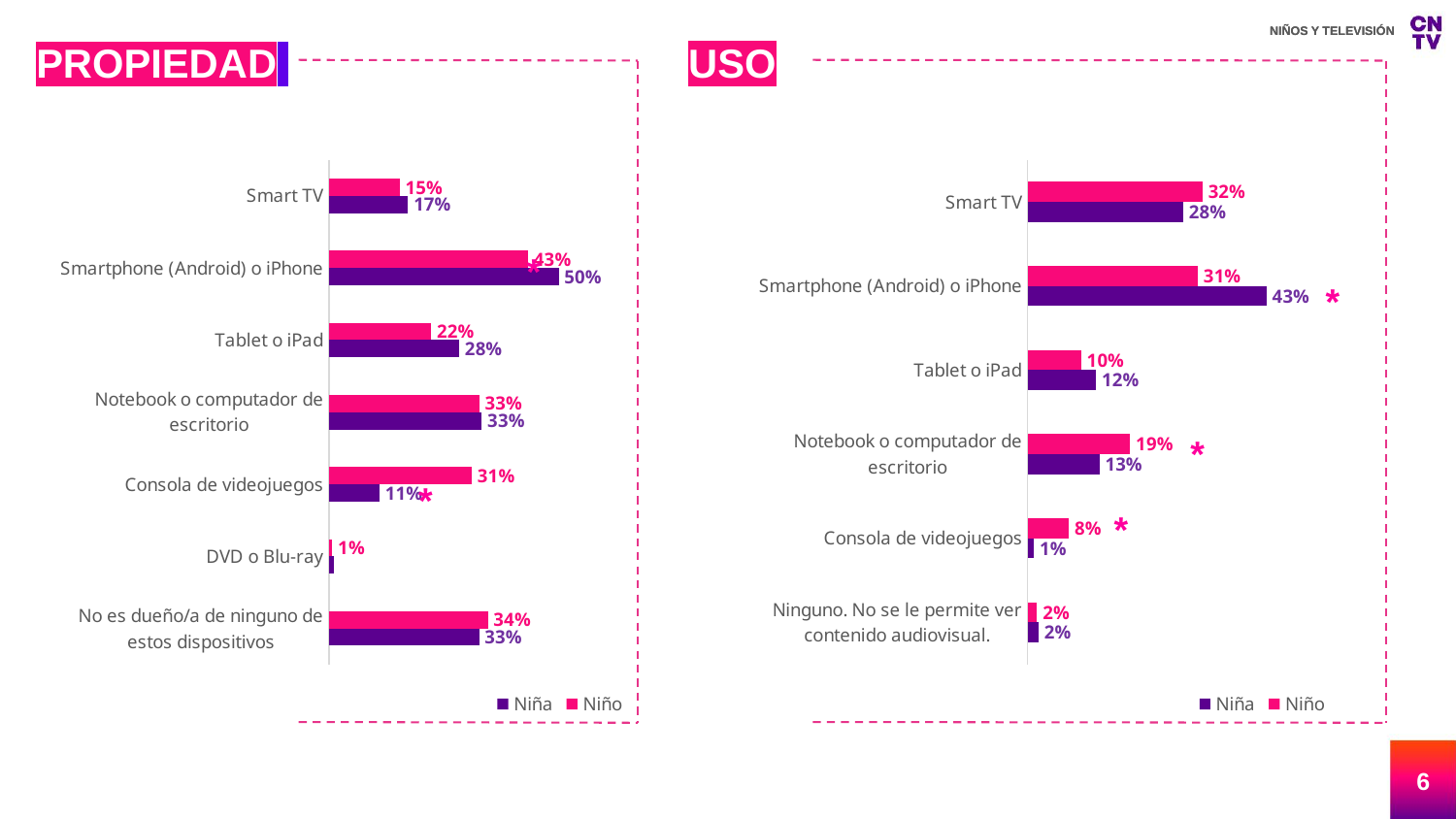
In the USO chart, what is the value for Niña for Smartphone (Android) o iPhone? 43% In the USO chart, what is the value for Niño for Notebook o computador de escritorio? 19% In the PROPIEDAD chart, which is larger for Tablet o iPad, the Niña value or the Niño value? Niña In the USO chart, which category has the lowest Niña value? Consola de videojuegos In the PROPIEDAD chart, what is the value for Niño for Consola de videojuegos? 31% In the PROPIEDAD chart, what is the difference between the Niño and Niña values for Consola de videojuegos? 20% How many series does the legend of the USO chart list? 2 What type of chart is the USO chart? Bar chart How many categories are shown in the PROPIEDAD chart? 7 In the PROPIEDAD chart, which category has the highest Niña value? Smartphone (Android) o iPhone In the PROPIEDAD chart, what is the value for Niña for Smartphone (Android) o iPhone? 50% In the USO chart, what is the difference between the Niño and Niña values for Smart TV? 4%